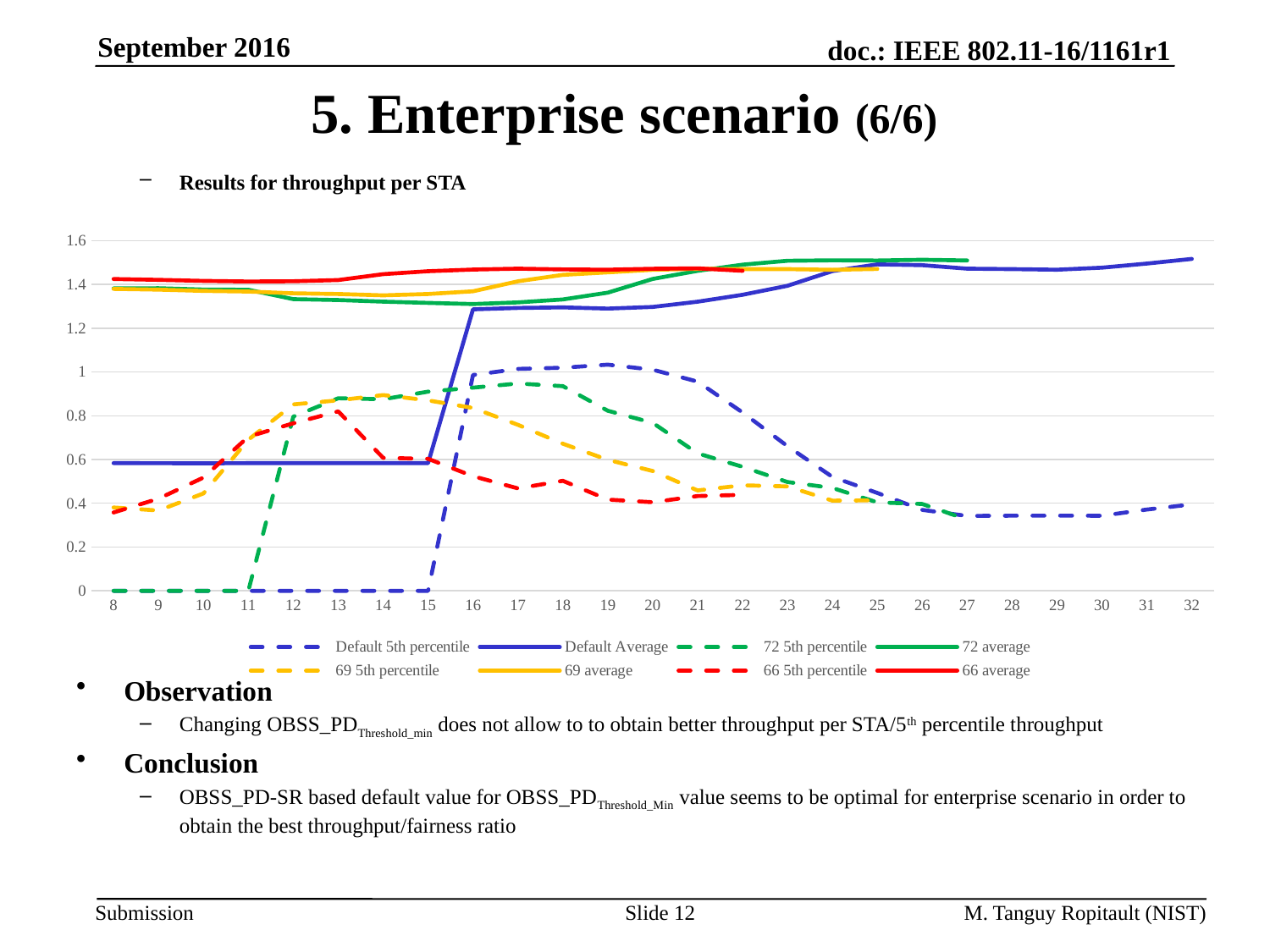
Is the value of Default Average at x = 16 greater or less than 1.2? greater How many series does the chart legend list? 8 At x = 8, which is larger: Default Average or 66 average? 66 average Is the value of 72 average at x = 16 greater or less than 1.4? less How many x-axis values are shown on the chart (from 8 to 32)? 25 What kind of chart is shown on the slide? line chart Is the value of Default Average at x = 8 greater or less than 0.8? less What is the value of the 72 5th percentile series at x = 10? 0 At x = 20, which is larger: Default 5th percentile or 66 5th percentile? Default 5th percentile Does the Default Average series rise or fall overall from x = 8 to x = 32? rise What is the value of the Default 5th percentile series at x = 8? 0